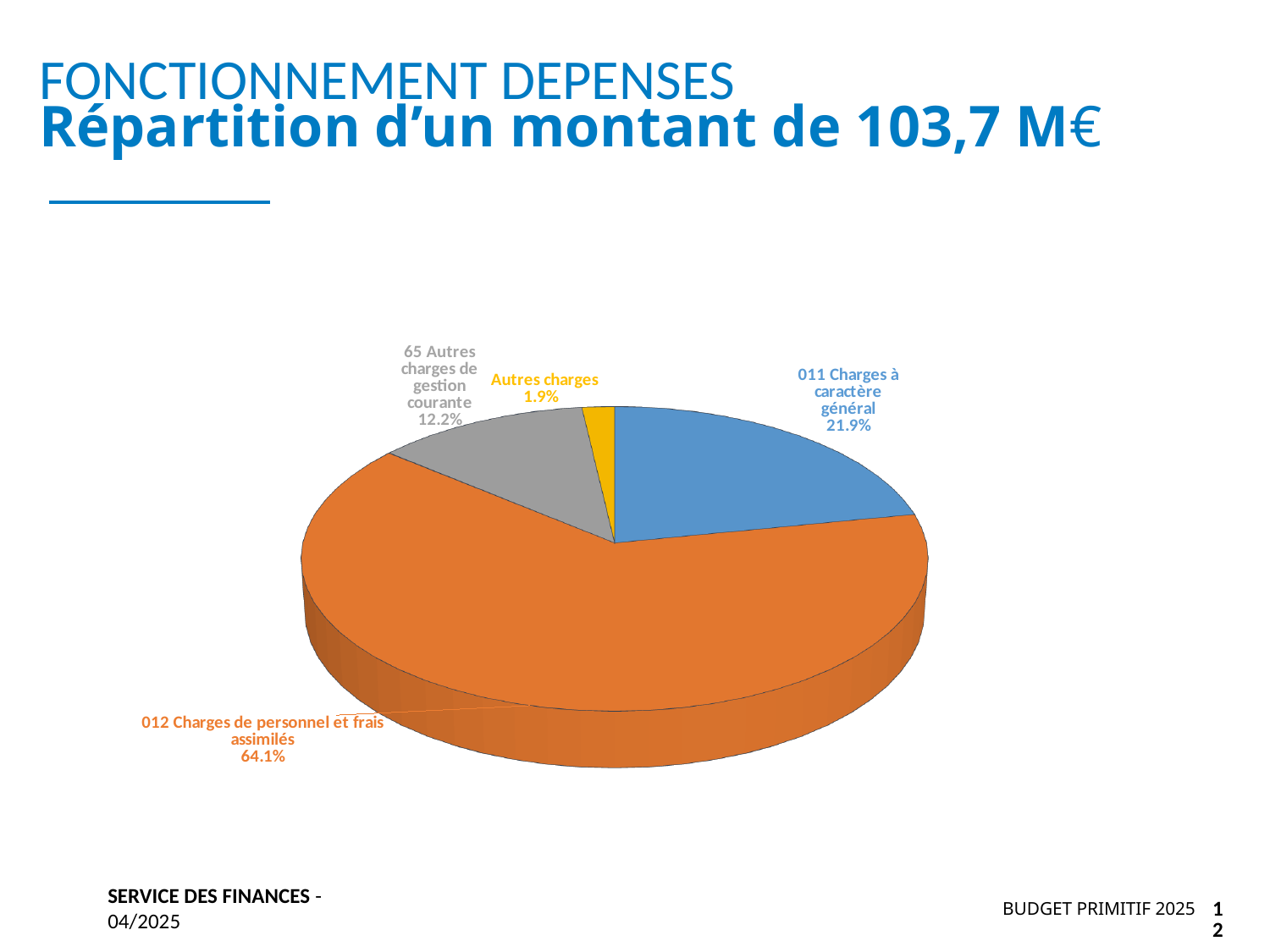
What share of the pie does "Autres charges" represent? 1.9% What share of the pie does "011 Charges à caractère général" represent? 21.9% What share of the pie does "65 Autres charges de gestion courante" represent? 12.2% What kind of chart is shown on the slide? pie chart How many slices does the pie chart have? 4 What colour is the slice for "012 Charges de personnel et frais assimilés"? orange Which category has the largest slice of the pie? 012 Charges de personnel et frais assimilés Which is larger: the share for "011 Charges à caractère général" or the share for "65 Autres charges de gestion courante"? 011 Charges à caractère général What is the difference in percentage points between "011 Charges à caractère général" and "65 Autres charges de gestion courante"? 9.7 Which category has the smallest slice of the pie? Autres charges What total amount does the slide title say is being distributed in the pie chart? 103,7 M€